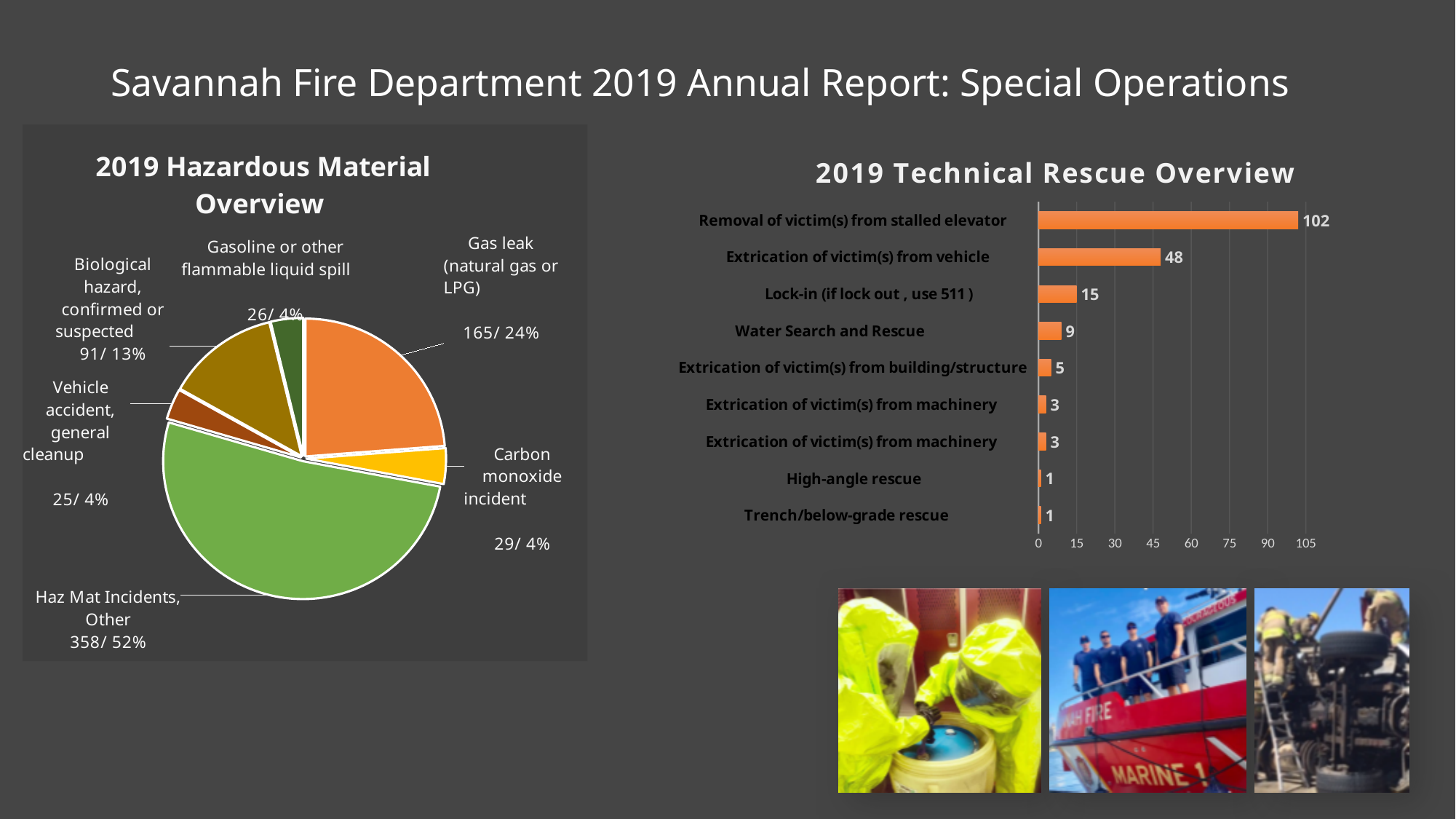
In the 2019 Technical Rescue Overview chart, how many incidents were removal of victim(s) from stalled elevator? 102 In the 2019 Technical Rescue Overview chart, what is the difference between extrication of victim(s) from vehicle and lock-in? 33 What type of chart is the 2019 Technical Rescue Overview? Bar chart In the 2019 Technical Rescue Overview chart, how many bars are plotted? 9 In the 2019 Hazardous Material Overview pie chart, how many slices are there? 6 In the 2019 Hazardous Material Overview pie chart, how many gas leak (natural gas or LPG) incidents were there? 165 In the 2019 Hazardous Material Overview pie chart, what share of incidents were Haz Mat Incidents, Other? 52% In the 2019 Technical Rescue Overview chart, what is the value for Water Search and Rescue? 9 In the 2019 Technical Rescue Overview chart, which category has the highest value? Removal of victim(s) from stalled elevator What type of chart is the 2019 Hazardous Material Overview? Pie chart In the 2019 Technical Rescue Overview chart, which is larger: Lock-in or Extrication of victim(s) from building/structure? Lock-in (if lock out , use 511 ) In the 2019 Hazardous Material Overview pie chart, which category has the smallest count? Vehicle accident, general cleanup